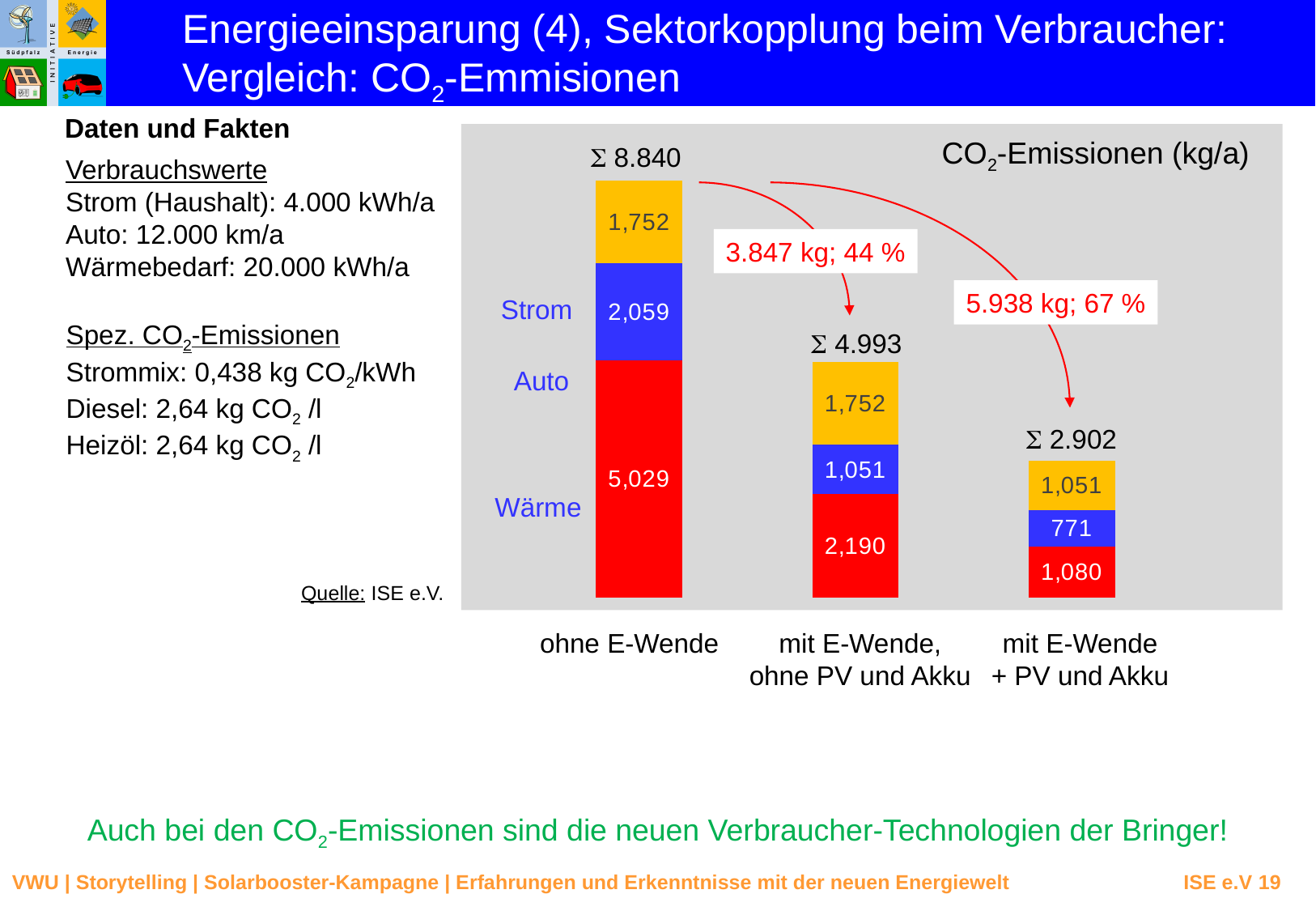
What is the total of the stacked bar for 'ohne E-Wende'? 8.840 What is the difference between the Wärme (red) value for 'ohne E-Wende' and the Wärme value for 'mit E-Wende, ohne PV und Akku'? 2,839 What is the value of the Strom (yellow) segment for 'mit E-Wende, ohne PV und Akku'? 1,752 What is the value of the Auto (blue) segment for 'mit E-Wende + PV und Akku'? 771 What is the value of the Wärme (red) segment for 'ohne E-Wende'? 5,029 What kind of chart is shown on the slide? Stacked bar chart Which category has the lowest total CO2 emissions? mit E-Wende + PV und Akku How many categories (bars) are shown in the chart? 3 How many series are stacked in each bar of the chart? 3 What is the total of the stacked bar for 'mit E-Wende + PV und Akku'? 2.902 Which category has the highest total CO2 emissions? ohne E-Wende Do the total CO2 emissions rise or fall from left to right across the three bars? Fall